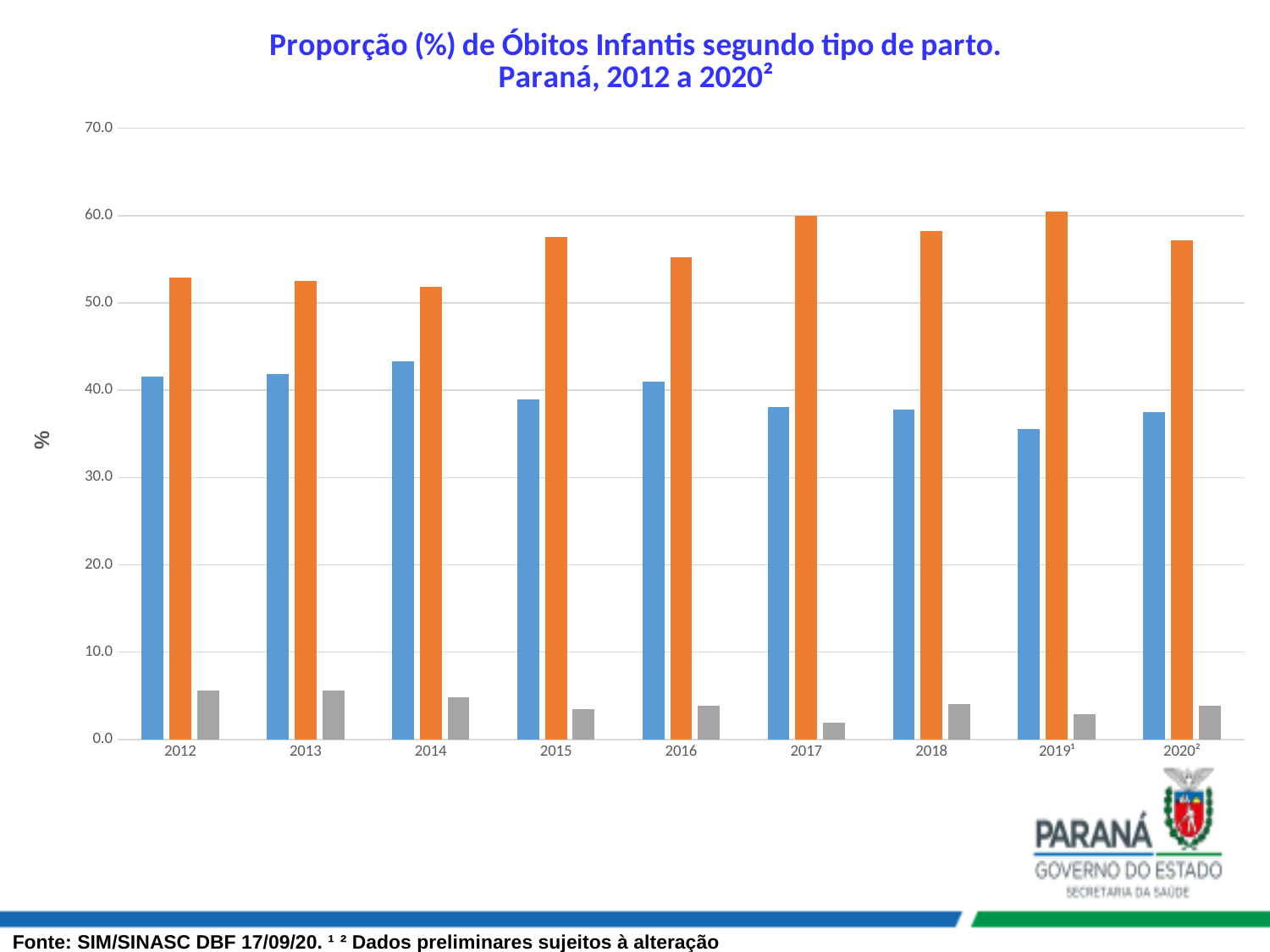
What is the title of the chart? Proporção (%) de Óbitos Infantis segundo tipo de parto. Paraná, 2012 a 2020² How many years are shown on the x axis of the chart? 9 What kind of chart is shown on the slide? bar chart Which year has the lowest blue bar? 2019¹ In 2012, which bar is taller, the blue bar or the orange bar? orange Do the blue bars generally rise or fall from 2012 to 2020²? fall Is the value of the blue bar for 2014 greater or less than 40? greater Is the value of the orange bar for 2017 greater or less than 50? greater Is the value of the blue bar for 2019¹ greater or less than 40? less How many bars are plotted for each year in the chart? 3 Which year has the lowest gray bar? 2017